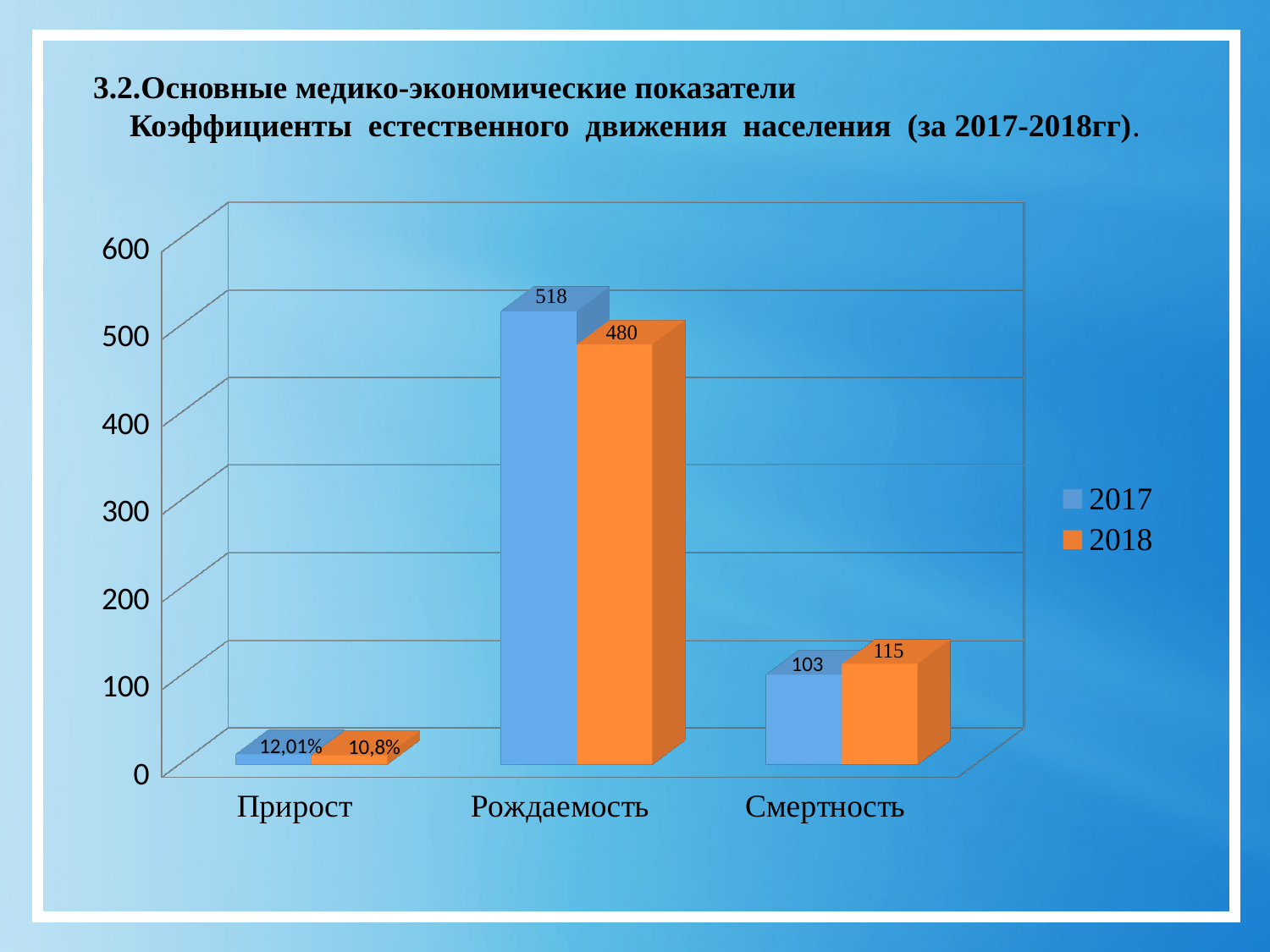
What is the value for Смертность in 2017? 103 Which category has the highest value in the 2017 series? Рождаемость What is the difference between the 2017 and 2018 values for Рождаемость? 38 Which is larger for Смертность: the 2017 value or the 2018 value? 2018 What is the value for Рождаемость in 2018? 480 How many series does the legend list? 2 What kind of chart is shown on the slide? Bar chart What is the value for Рождаемость in 2017? 518 Which category has the lowest value in the 2018 series? Прирост What is the value for Смертность in 2018? 115 What is the data label for Прирост in 2018? 10,8% What is the data label for Прирост in 2017? 12,01%